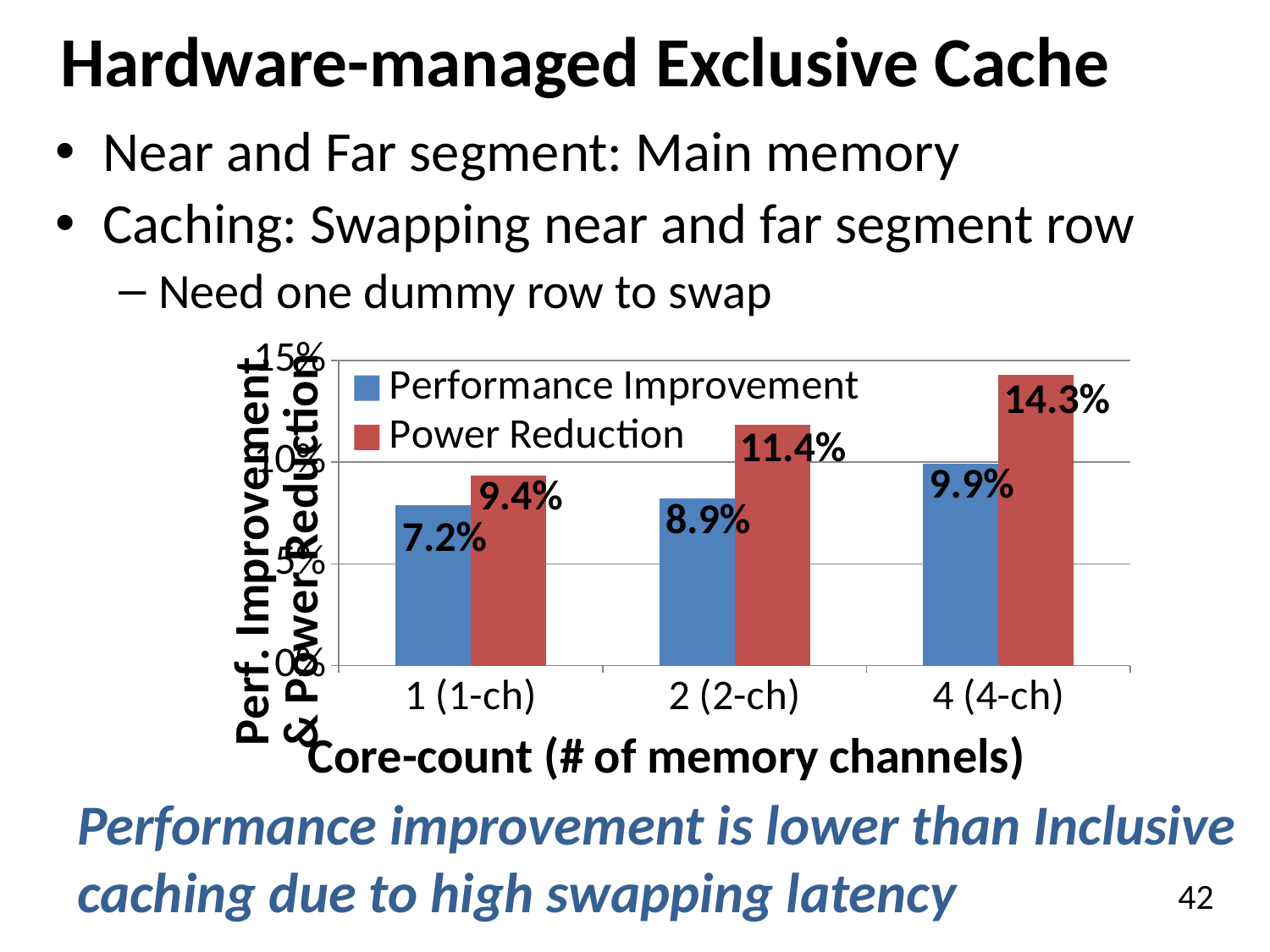
How many series does the legend list? 2 Does Performance Improvement rise or fall as core-count increases along the x axis? rise What is the Power Reduction for 4 (4-ch)? 14.3% What is the Performance Improvement for 1 (1-ch)? 7.2% What is the difference between Power Reduction and Performance Improvement for 4 (4-ch)? 4.4% Is the Power Reduction for 1 (1-ch) greater or less than 10%? less How many core-count categories are shown on the x axis? 3 Which core-count category has the lowest Performance Improvement? 1 (1-ch) Which is larger for 2 (2-ch): Performance Improvement or Power Reduction? Power Reduction Which core-count category has the highest Power Reduction? 4 (4-ch) What is the Power Reduction for 2 (2-ch)? 11.4% What is the Performance Improvement for 4 (4-ch)? 9.9%